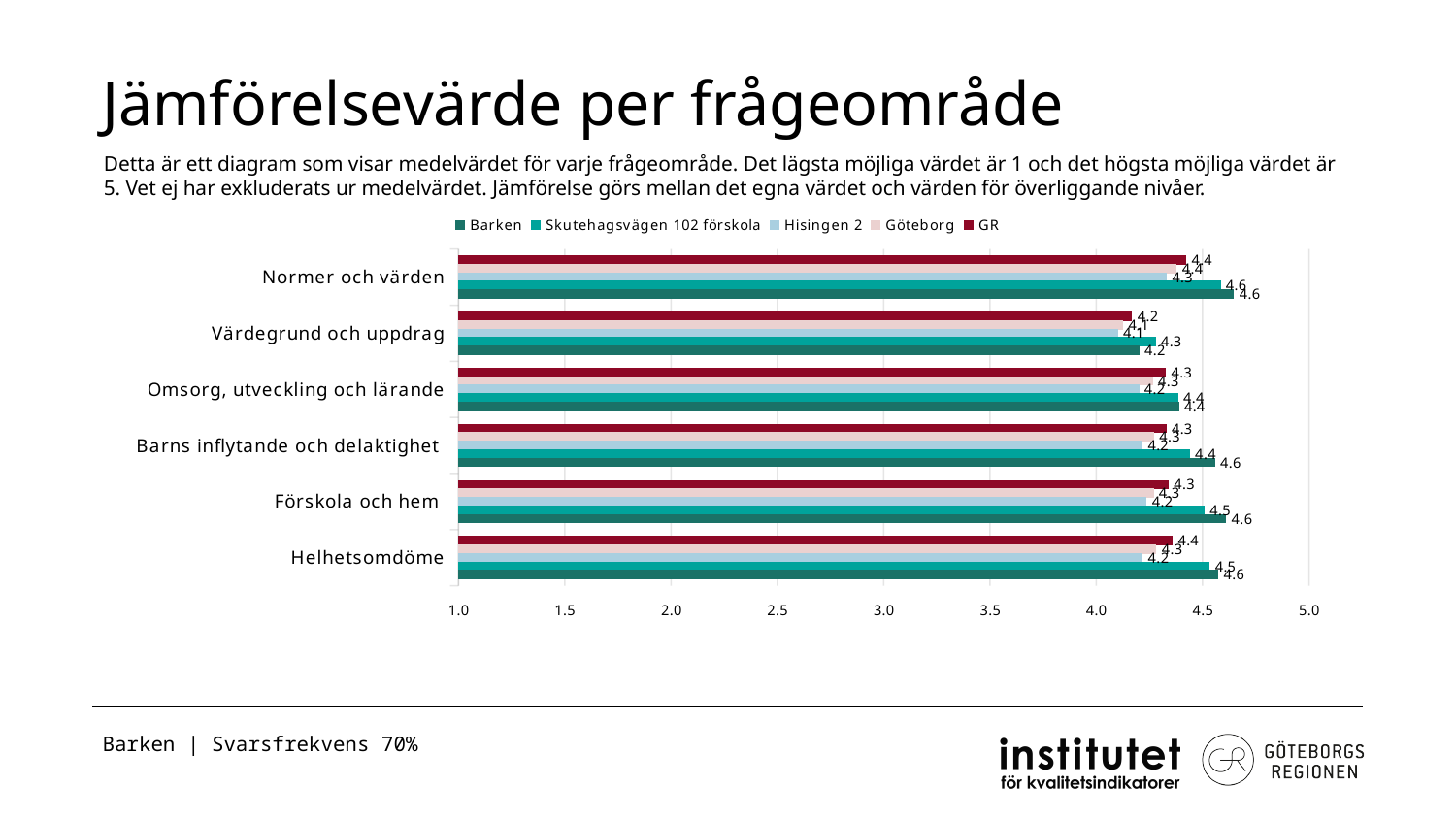
Is the value for Barken in Värdegrund och uppdrag greater or less than 4.5? less For which question area does Barken have its lowest value? Värdegrund och uppdrag What is the value for Barken in Barns inflytande och delaktighet? 4.6 Which series is shown in dark red in the legend? GR What is the difference between Barken and Skutehagsvägen 102 förskola in Barns inflytande och delaktighet? 0.2 What is the value for Skutehagsvägen 102 förskola in Förskola och hem? 4.5 What kind of chart is shown on the slide? bar chart What is the value for Barken in Värdegrund och uppdrag? 4.2 How many question areas (categories) are shown on the y axis? 6 Which is larger in Förskola och hem: the value for Barken or the value for Hisingen 2? Barken What is the value for GR in Värdegrund och uppdrag? 4.2 How many series does the legend list? 5